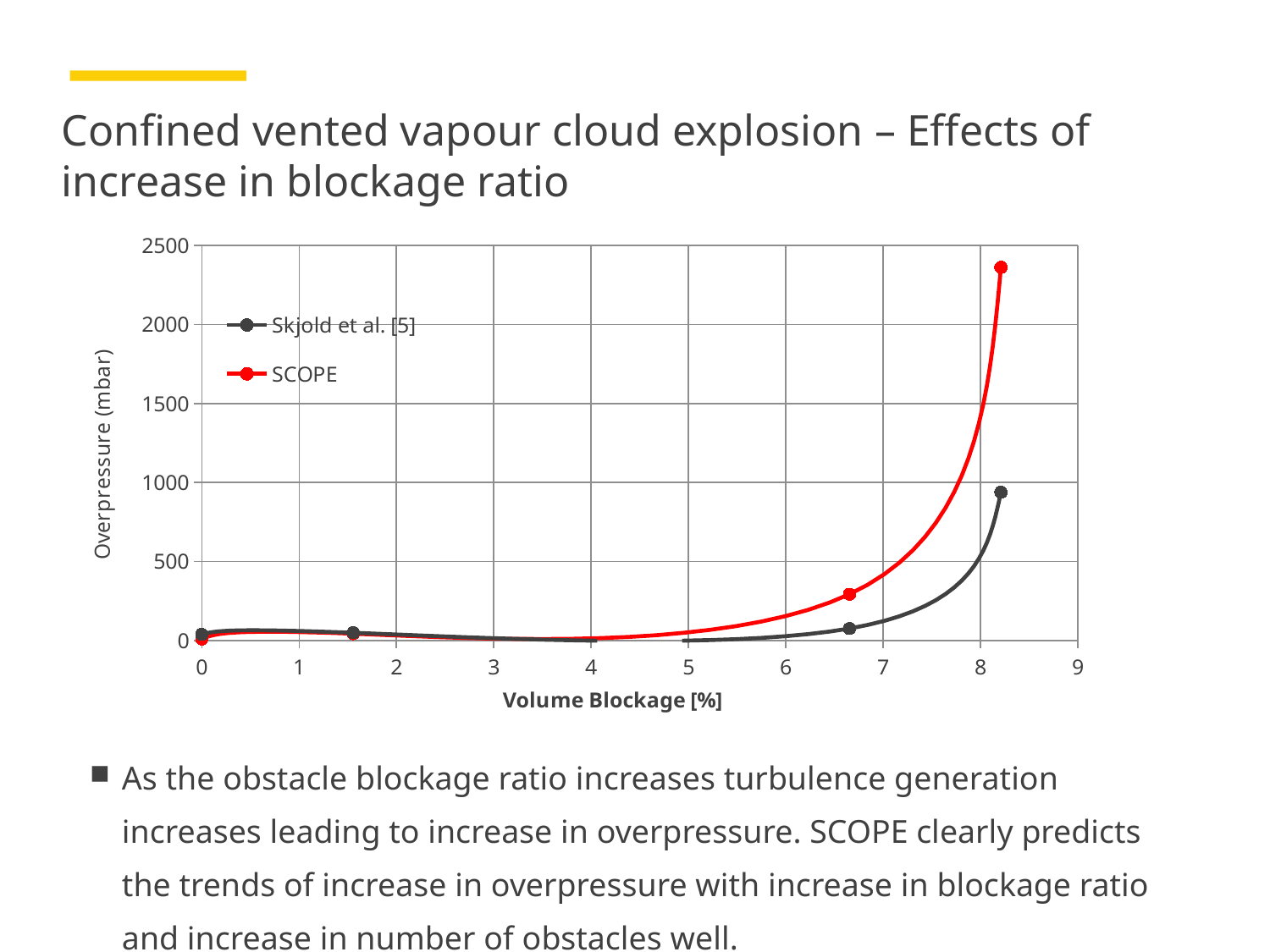
Is the SCOPE overpressure at the highest volume blockage plotted greater or less than 2000 mbar? greater Is the Skjold et al. [5] overpressure at the highest volume blockage plotted greater or less than 500 mbar? greater At the highest volume blockage plotted, which series shows the larger overpressure, SCOPE or Skjold et al. [5]? SCOPE Overall, does the overpressure rise or fall as volume blockage increases along the x axis? rise How many series does the chart legend list? 2 How many data points are plotted for the SCOPE series? 4 What kind of chart is shown on the slide? line chart What is the label of the vertical axis of the chart? Overpressure (mbar) At a volume blockage of about 6.7%, which series shows the larger overpressure, SCOPE or Skjold et al. [5]? SCOPE Which series is drawn in red? SCOPE Is the SCOPE overpressure at a volume blockage of about 6.7% greater or less than 500 mbar? less What is the label of the horizontal axis of the chart? Volume Blockage [%]